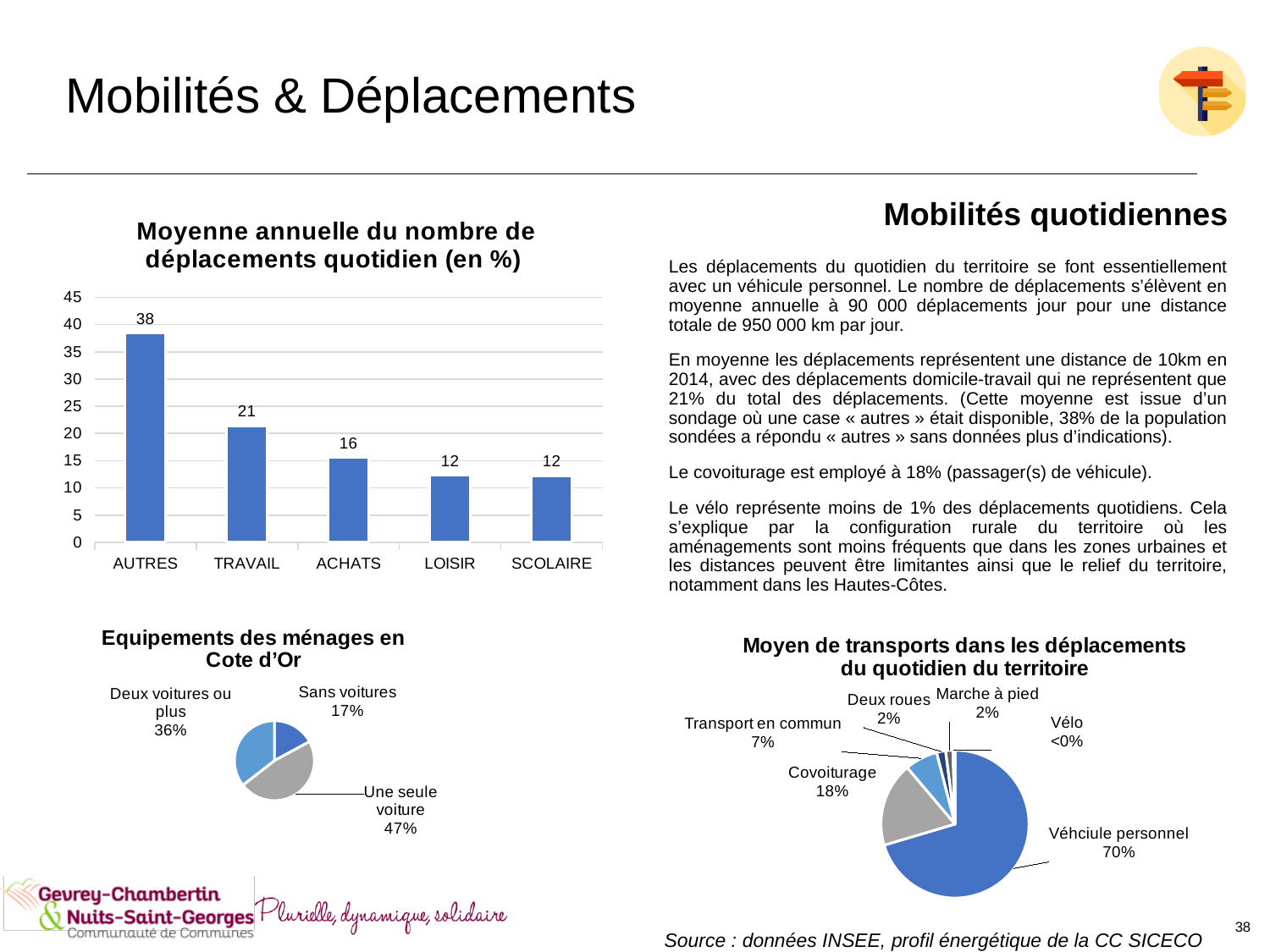
In the chart 'Moyenne annuelle du nombre de déplacements quotidien (en %)', do the values rise or fall from AUTRES to SCOLAIRE? Fall In the pie chart 'Moyen de transports dans les déplacements du quotidien du territoire', what share is Covoiturage? 18% In the chart 'Moyenne annuelle du nombre de déplacements quotidien (en %)', which category has the highest value? AUTRES In the chart 'Moyenne annuelle du nombre de déplacements quotidien (en %)', which is larger, the value for TRAVAIL or the value for ACHATS? TRAVAIL In the chart 'Moyenne annuelle du nombre de déplacements quotidien (en %)', what is the value for TRAVAIL? 21 In the pie chart 'Equipements des ménages en Cote d'Or', what share is 'Une seule voiture'? 47% In the chart 'Moyenne annuelle du nombre de déplacements quotidien (en %)', what is the difference between the values for AUTRES and ACHATS? 22 In the chart 'Moyenne annuelle du nombre de déplacements quotidien (en %)', how many categories are shown on the x axis? 5 In the pie chart 'Equipements des ménages en Cote d'Or', which slice is the smallest? Sans voitures What kind of chart is 'Moyenne annuelle du nombre de déplacements quotidien (en %)'? Bar chart In the pie chart 'Moyen de transports dans les déplacements du quotidien du territoire', what is the difference between the shares for Véhcule personnel and Transport en commun? 63% In the pie chart 'Moyen de transports dans les déplacements du quotidien du territoire', which slice is the largest? Véhciule personnel